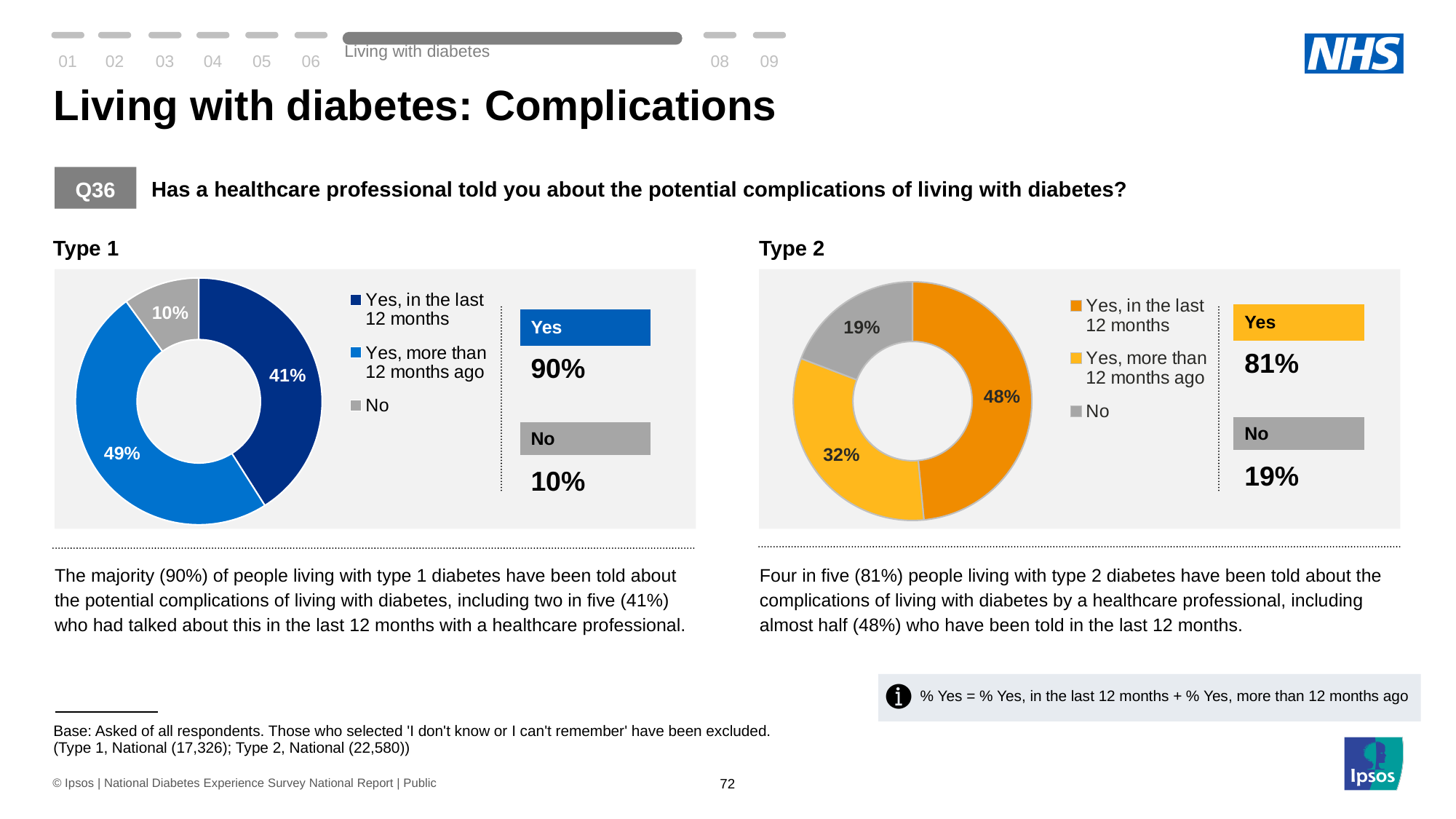
In the Type 2 chart, what percentage of respondents said 'No'? 19% Which is larger in the Type 1 chart: 'Yes, in the last 12 months' or 'No'? Yes, in the last 12 months What is the combined 'Yes' percentage shown for Type 2? 81% In the Type 2 chart, what is the difference between the 'Yes, in the last 12 months' and 'Yes, more than 12 months ago' shares? 16% In the Type 1 chart, which category has the largest share? Yes, more than 12 months ago In the Type 2 chart, which category has the smallest share? No What colour represents 'No' in the Type 1 chart? Grey In the Type 2 chart, what percentage of respondents said 'Yes, more than 12 months ago'? 32% In the Type 1 chart, what percentage of respondents said 'Yes, more than 12 months ago'? 49% In the Type 1 chart, what percentage of respondents said 'Yes, in the last 12 months'? 41% How many categories does the legend of the Type 2 chart list? 3 What kind of chart is used for the Type 1 data? Doughnut (pie) chart